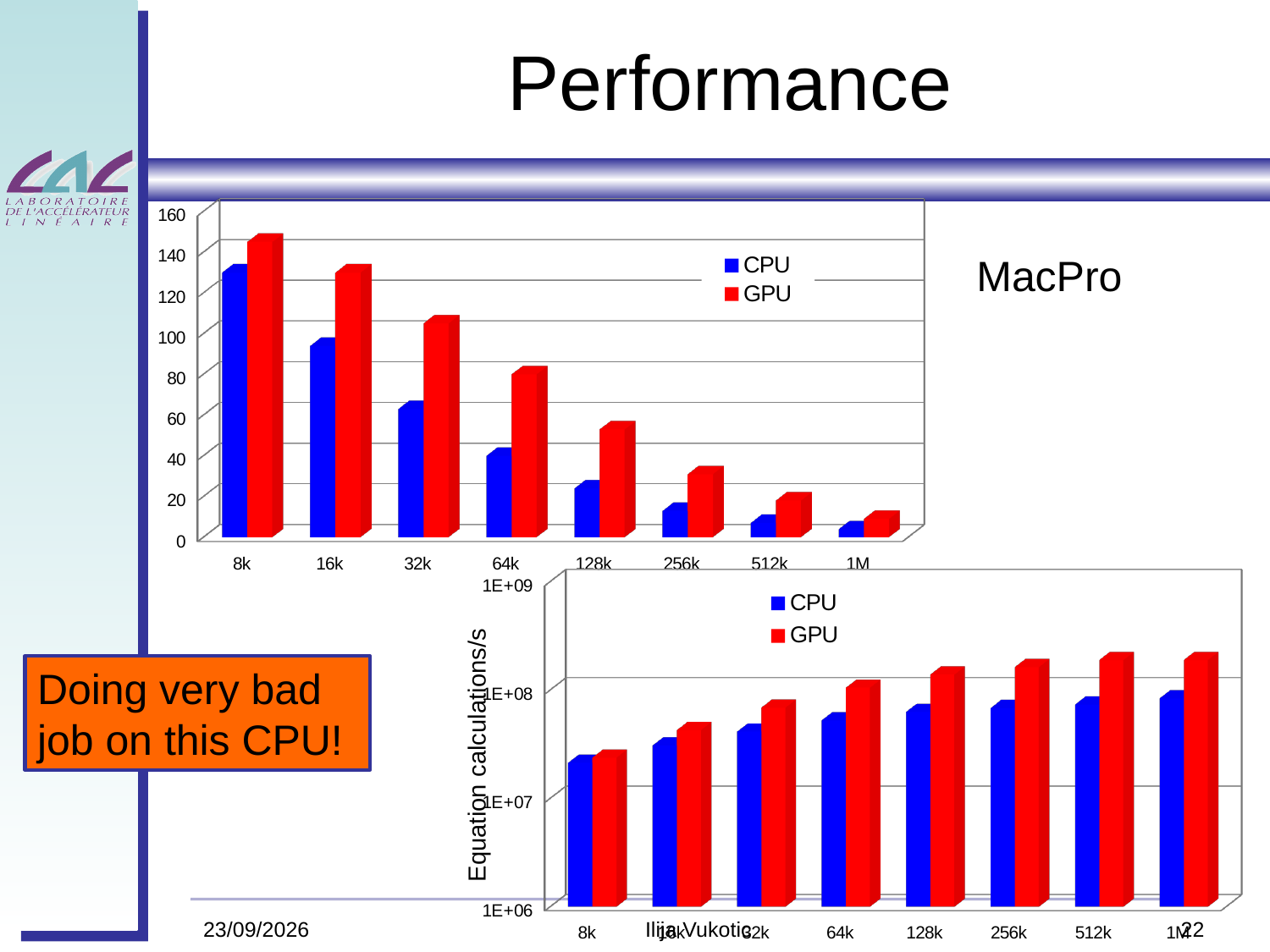
How many series does the legend of the top chart list? 2 In the bottom chart, is the GPU value for 1M greater or less than 1E+08? greater In the top chart, do the values rise or fall as you move from 8k to 1M along the x axis? fall In the bottom chart, do the CPU values rise or fall as you move from 8k to 1M along the x axis? rise In the top chart, is the GPU value for 8k greater or less than 140? greater In the top chart, is the CPU value for 16k greater or less than 100? less In the top chart, which is larger at 32k, the CPU value or the GPU value? GPU How many categories are shown on the x axis of the top chart? 8 What kind of chart is the top chart on the slide? bar chart In the top chart, which category has the highest GPU value? 8k In the top chart, which category has the lowest CPU value? 1M What is the y-axis label of the bottom chart? Equation calculations/s